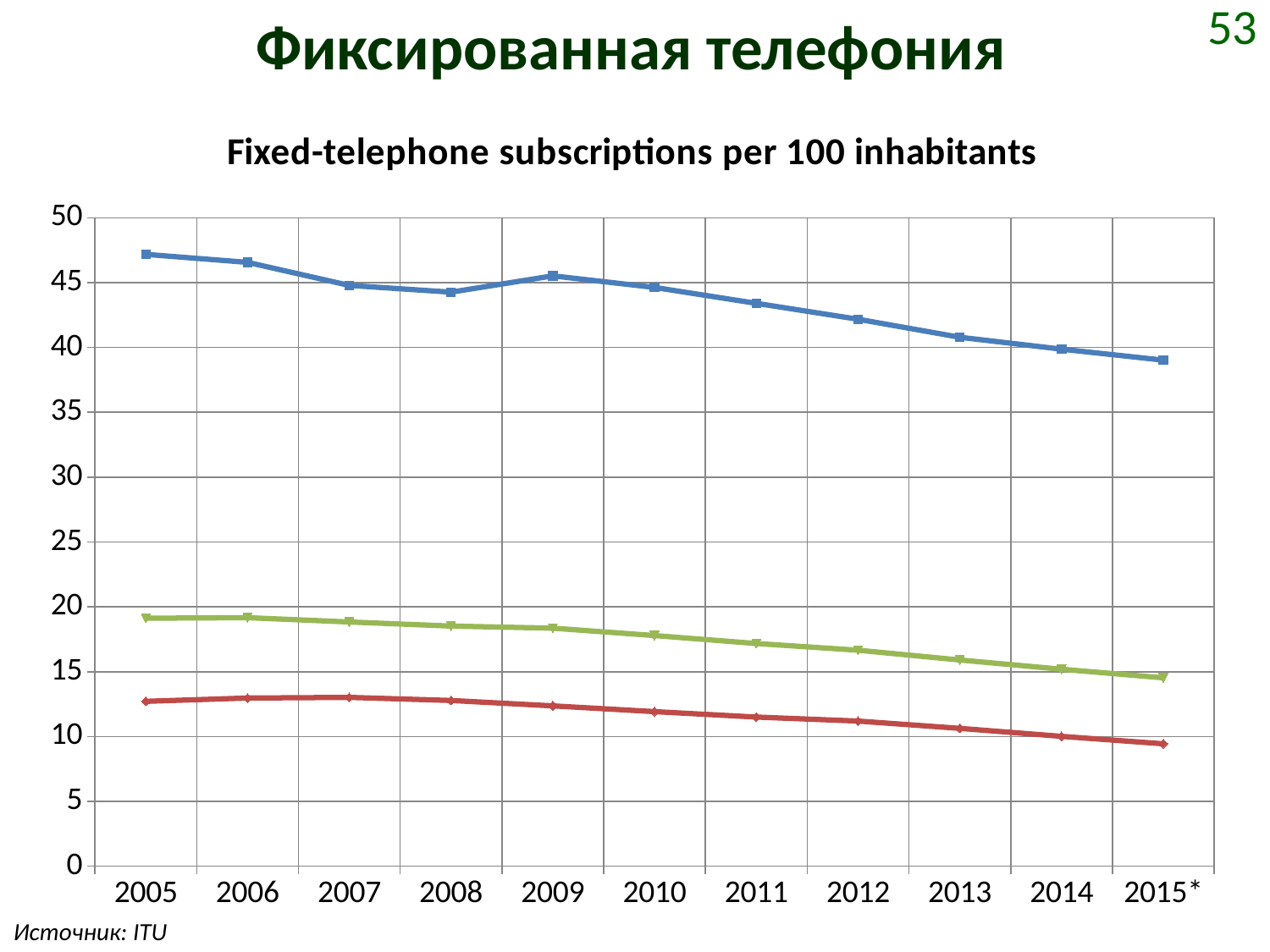
Does the blue line rise or fall overall from 2005 to 2015*? fall Is the value of the blue line in 2015* greater or less than 40? less In which year is the blue line at its highest value? 2005 Is the value of the green line in 2005 greater or less than 20? less Is the value of the red line in 2015* greater or less than 10? less What is the title of the chart? Fixed-telephone subscriptions per 100 inhabitants What kind of chart is shown on the slide? line chart How many lines are plotted on the chart? 3 In 2010, which line has the larger value, the blue line or the green line? blue line How many years are shown on the x axis of the chart? 11